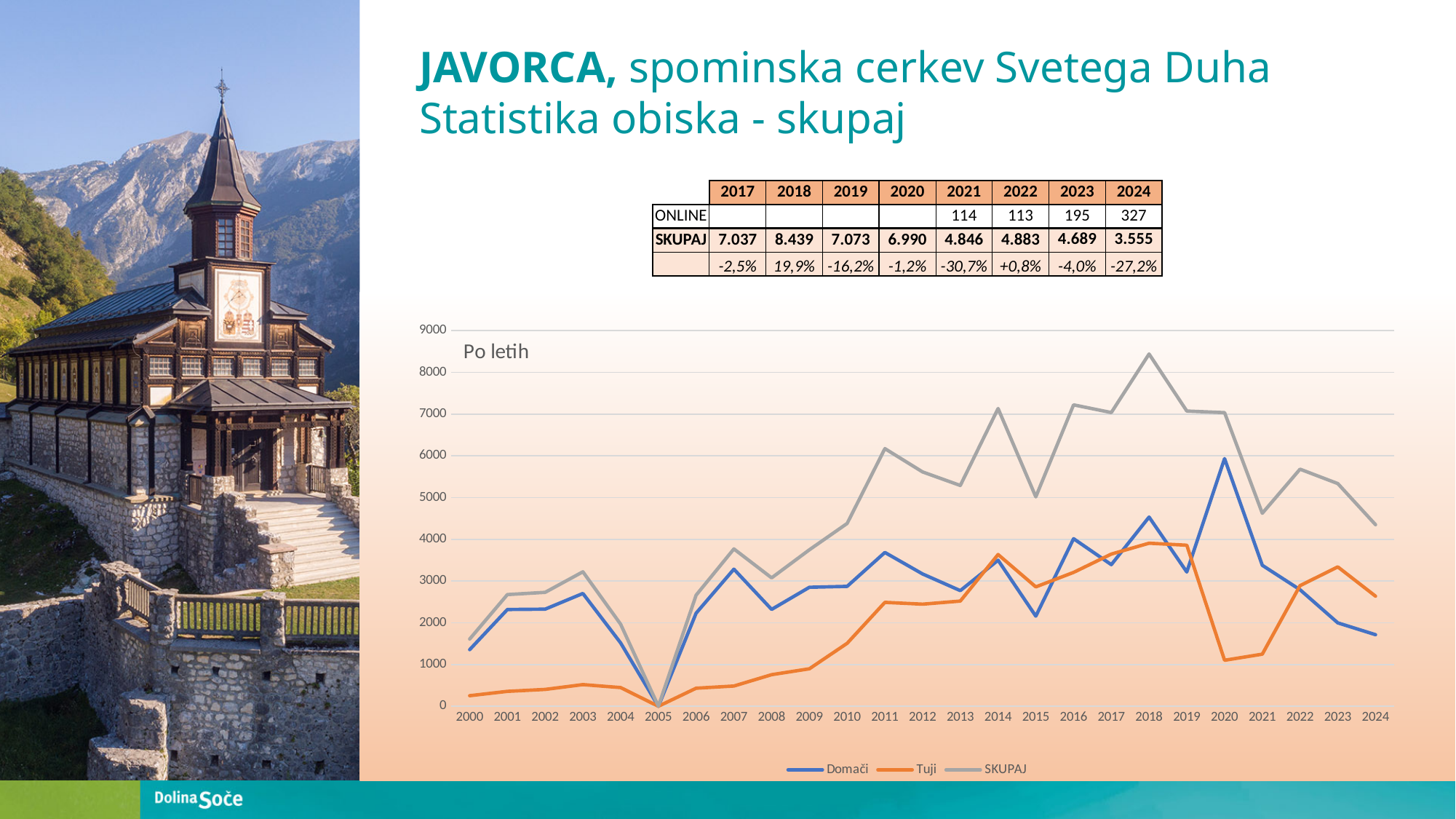
Does the Domači line rise or fall from 2020 to 2024? fall How many series does the chart legend list? 3 What is the title printed inside the chart area? Po letih In which year does the SKUPAJ line reach its highest value? 2018 In 2020, which is larger, the Domači value or the Tuji value? Domači In which year does the Domači line reach its highest value? 2020 In 2024, which is larger, the Domači value or the Tuji value? Tuji What kind of chart is shown on the slide? line chart Is the SKUPAJ value for 2018 greater or less than 8000? greater Is the Tuji value for 2020 greater or less than 2000? less How many years are plotted along the x axis of the chart? 25 In which year do all three lines reach their lowest value? 2005